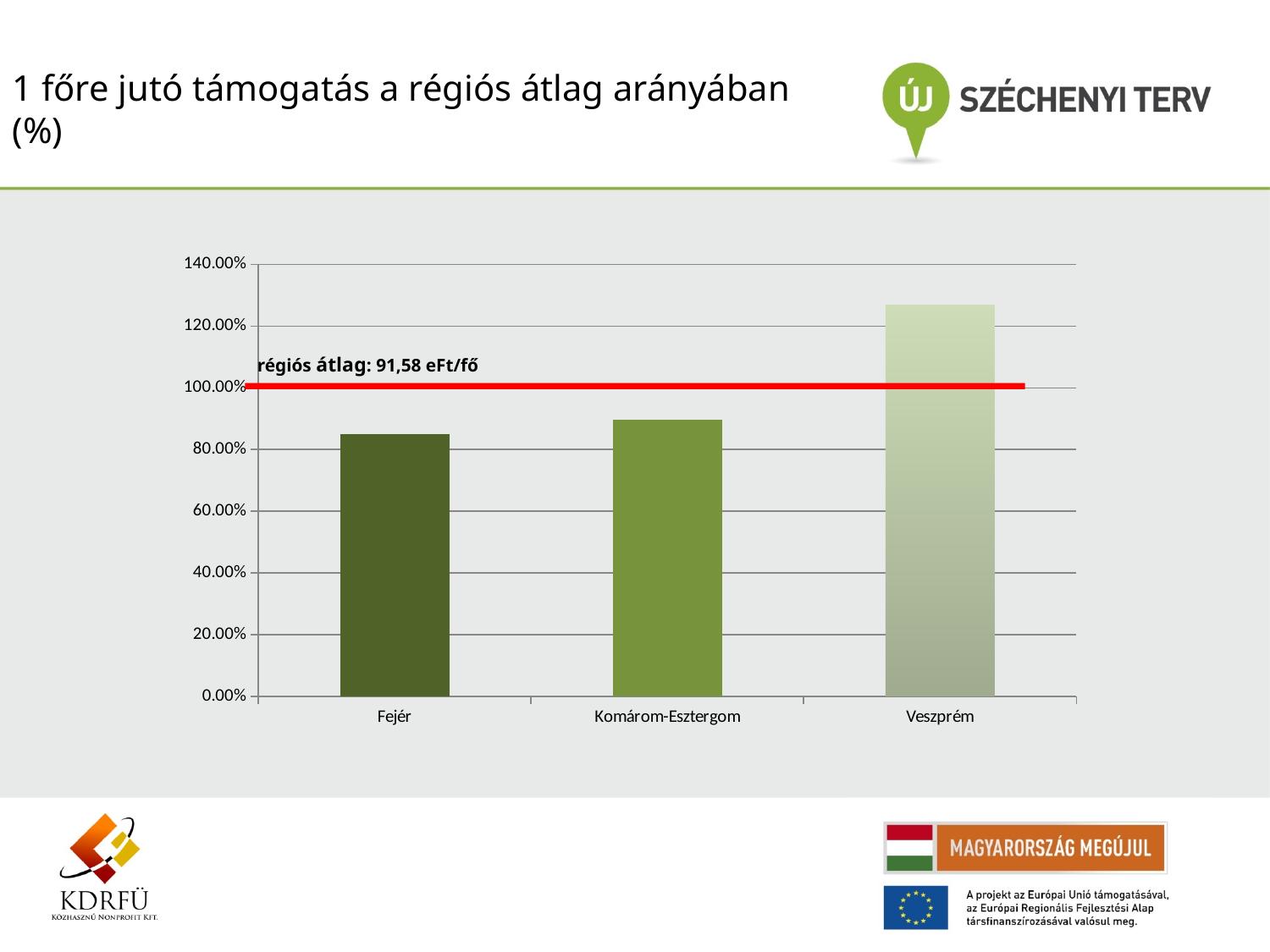
What kind of chart is shown on the slide? bar chart What is the title of the slide containing the chart? 1 főre jutó támogatás a régiós átlag arányában (%) Which is larger, the value for Komárom-Esztergom or the value for Veszprém? Veszprém Is the value for Komárom-Esztergom greater or less than 100.00%? less What does the label on the red horizontal line in the chart say? régiós átlag: 91,58 eFt/fő Which is larger, the value for Veszprém or the value for Fejér? Veszprém Which county has the highest value in the chart? Veszprém Is the value for Veszprém greater or less than 120.00%? greater Is the value for Fejér greater or less than 80.00%? greater Which county has the lowest value in the chart? Fejér How many categories (counties) are shown on the x axis of the chart? 3